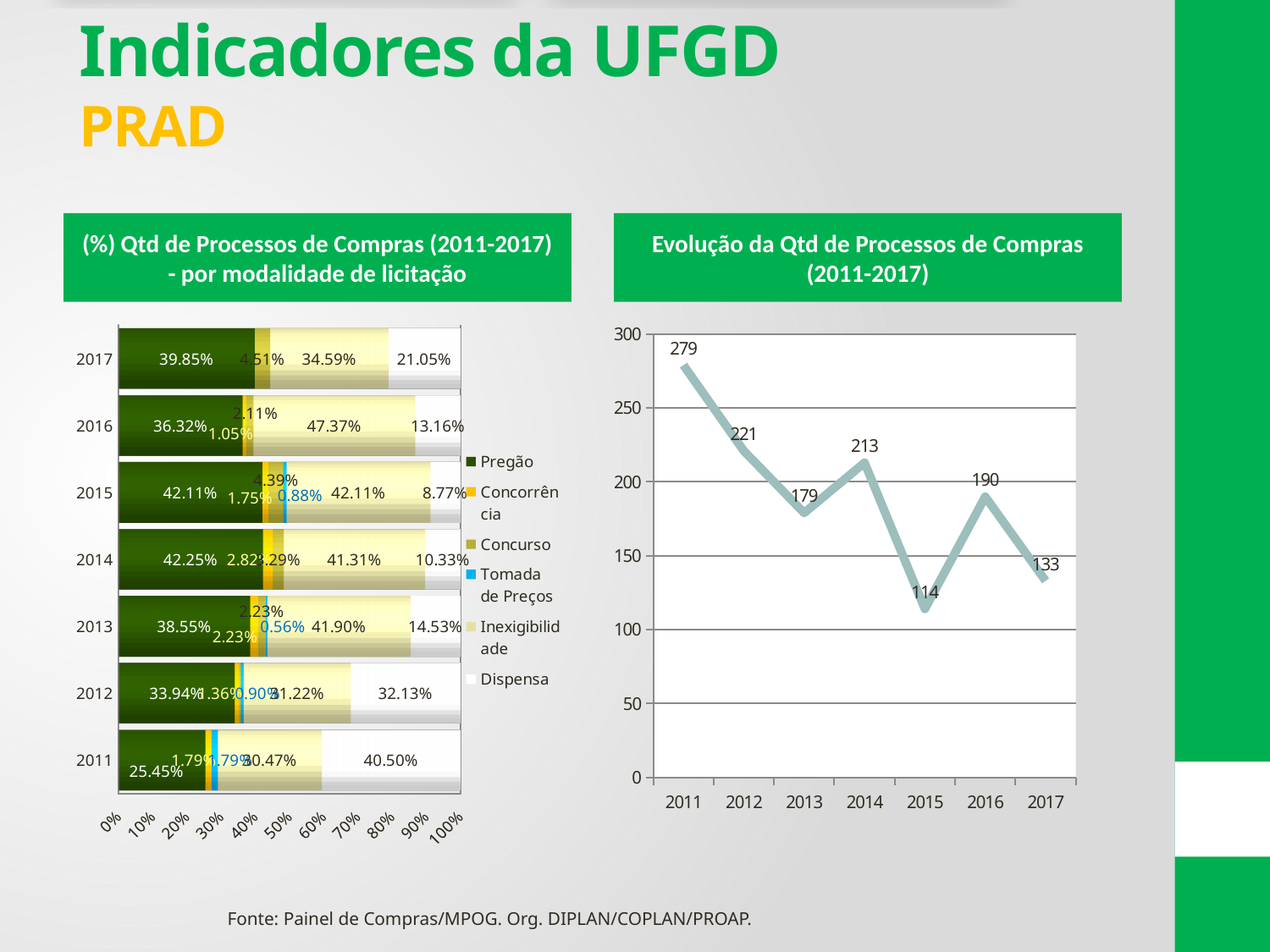
In the chart 'Evolução da Qtd de Processos de Compras (2011-2017)', which year has the lowest value? 2015 In the chart '(%) Qtd de Processos de Compras (2011-2017) - por modalidade de licitação', what is the Dispensa share for 2011? 40.50% In the chart '(%) Qtd de Processos de Compras (2011-2017) - por modalidade de licitação', what is the Pregão share for 2017? 39.85% In the chart 'Evolução da Qtd de Processos de Compras (2011-2017)', what is the difference between the values for 2011 and 2017? 146 In the chart 'Evolução da Qtd de Processos de Compras (2011-2017)', which year has the highest value? 2011 What kind of chart is 'Evolução da Qtd de Processos de Compras (2011-2017)'? Line chart In the chart 'Evolução da Qtd de Processos de Compras (2011-2017)', how many years are plotted? 7 In the chart 'Evolução da Qtd de Processos de Compras (2011-2017)', what is the value for 2015? 114 How many series does the legend of the chart '(%) Qtd de Processos de Compras (2011-2017) - por modalidade de licitação' list? 6 In the chart 'Evolução da Qtd de Processos de Compras (2011-2017)', which year has the larger value, 2014 or 2016? 2014 In the chart 'Evolução da Qtd de Processos de Compras (2011-2017)', what is the value for 2011? 279 What kind of chart is '(%) Qtd de Processos de Compras (2011-2017) - por modalidade de licitação'? Stacked bar chart